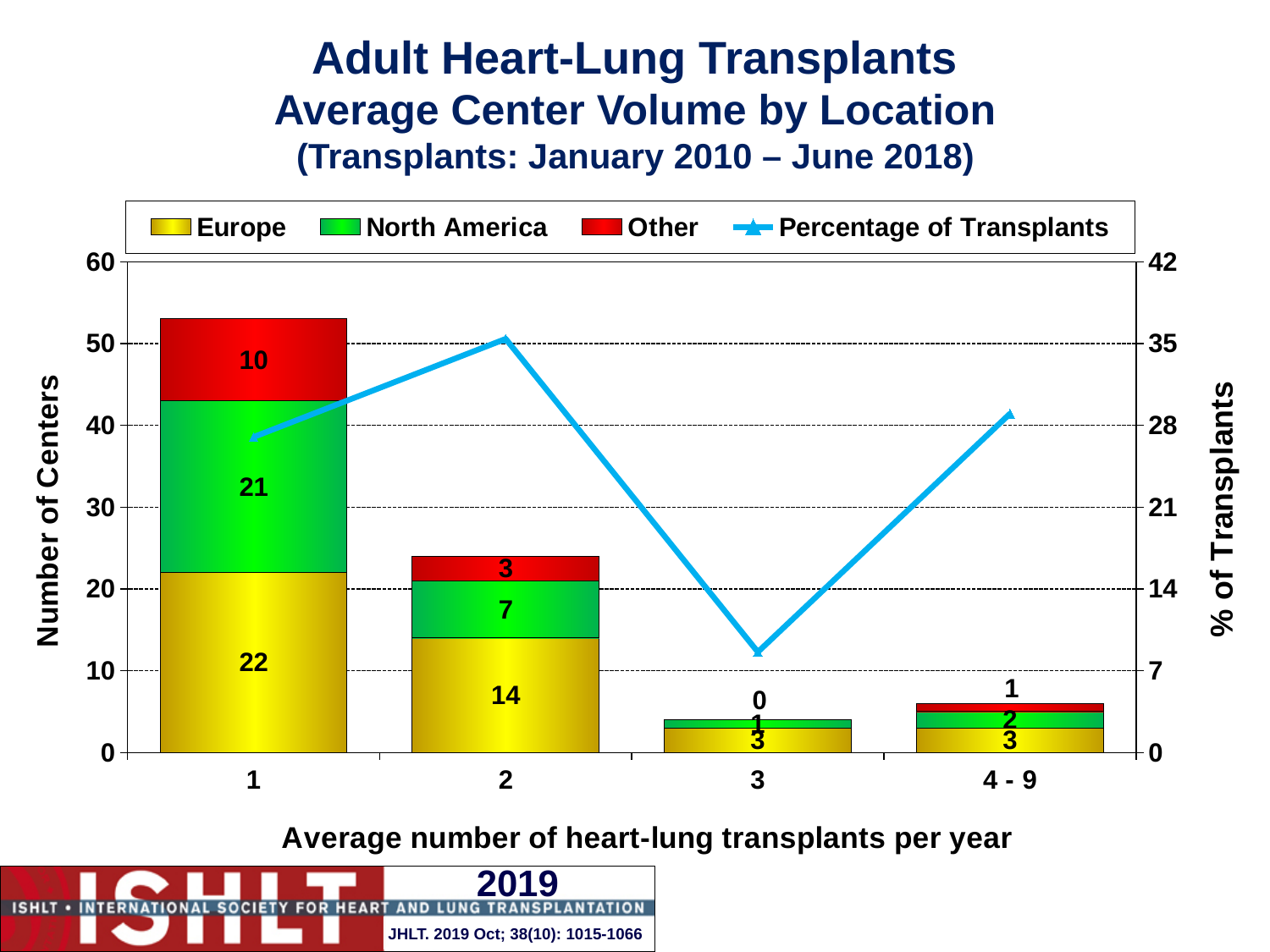
What is the number of Europe centers for the category 1? 22 Is the Percentage of Transplants for category 3 greater or less than 14? less What is the number of North America centers for the category 2? 7 How many series does the legend list? 4 Which category has the highest number of Europe centers? 1 What is the difference between the number of Europe centers for category 1 and category 2? 8 Which category has the lowest number of Other centers? 3 Is the Percentage of Transplants for category 2 greater or less than 28? greater Which is larger, the number of North America centers for category 1 or the number of Other centers for category 1? North America centers for category 1 What is the total number of centers in the stacked bar for category 1? 53 What is the number of Other centers for the category 4 - 9? 1 What is the total number of centers in the stacked bar for category 2? 24